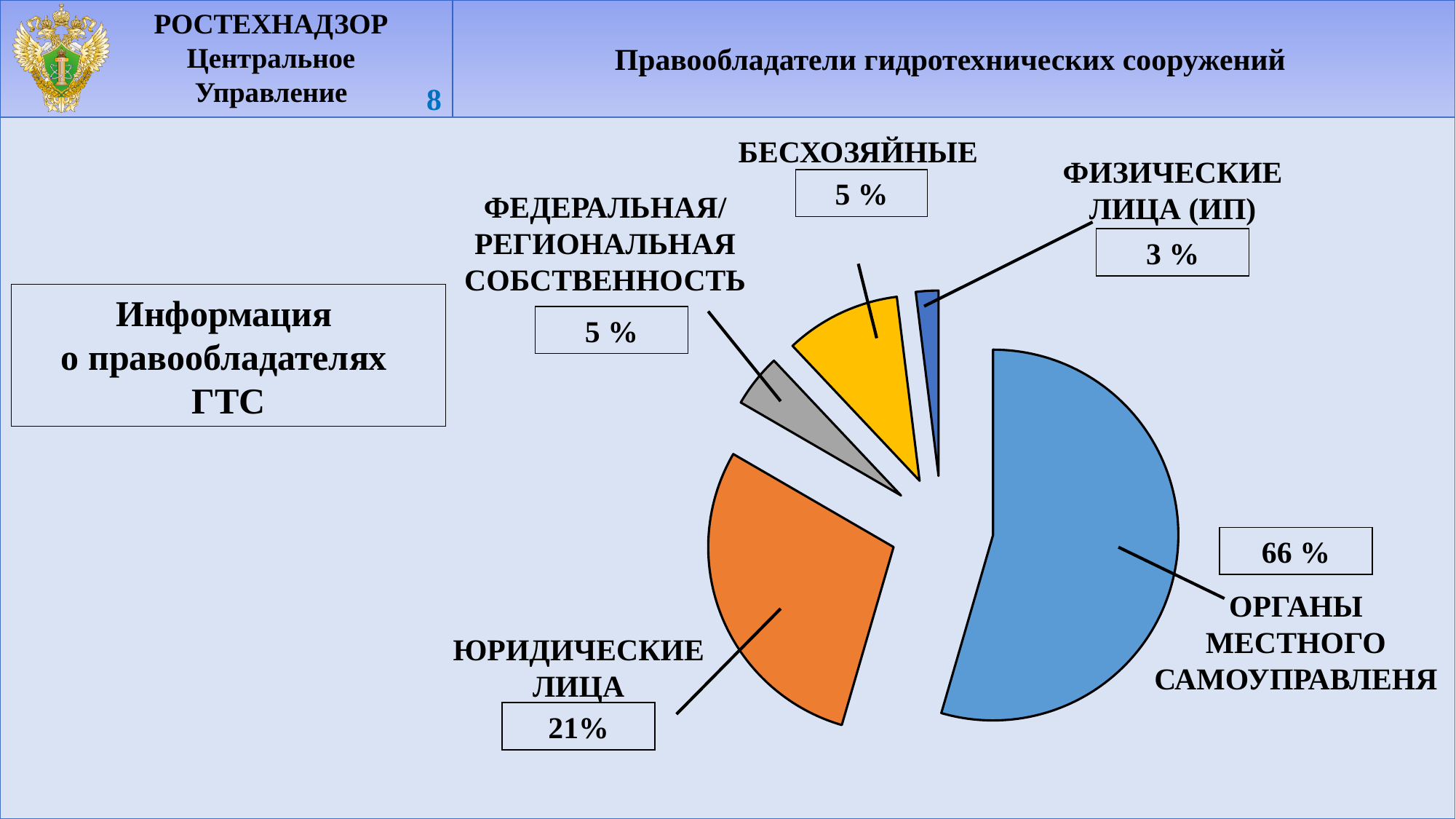
What value is shown for ФИЗИЧЕСКИЕ ЛИЦА (ИП)? 3 % What value is shown for БЕСХОЗЯЙНЫЕ? 5 % What value is shown for ФЕДЕРАЛЬНАЯ/РЕГИОНАЛЬНАЯ СОБСТВЕННОСТЬ? 5 % What colour is the slice for ЮРИДИЧЕСКИЕ ЛИЦА? Orange How many slices does the pie chart have? 5 Which is larger, the slice for ЮРИДИЧЕСКИЕ ЛИЦА or the slice for БЕСХОЗЯЙНЫЕ? ЮРИДИЧЕСКИЕ ЛИЦА Which category has the largest slice of the pie chart? ОРГАНЫ МЕСТНОГО САМОУПРАВЛЕНЯ What is the difference in percentage points between ОРГАНЫ МЕСТНОГО САМОУПРАВЛЕНЯ and ЮРИДИЧЕСКИЕ ЛИЦА? 45 What type of chart is shown on the slide? Pie chart What value is shown for ЮРИДИЧЕСКИЕ ЛИЦА? 21% Which category has the smallest slice of the pie chart? ФИЗИЧЕСКИЕ ЛИЦА (ИП) What share of the pie chart is labelled for ОРГАНЫ МЕСТНОГО САМОУПРАВЛЕНЯ? 66 %